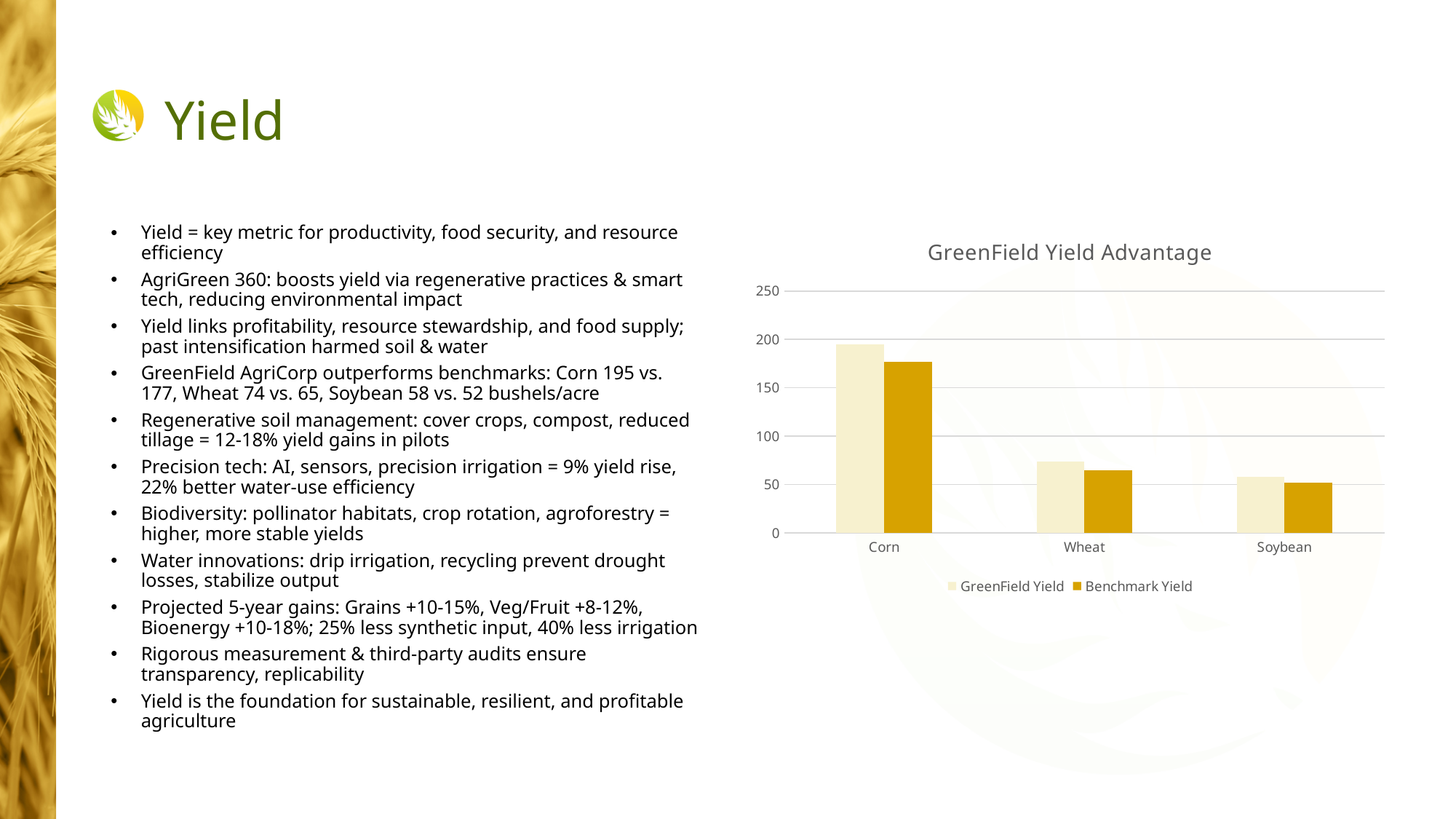
Which crop has the lowest Benchmark Yield in the chart? Soybean How many series does the chart legend list? 2 What is the GreenField Yield for Corn, as stated on the slide? 195 What is the difference between the GreenField Yield and the Benchmark Yield for Corn, using the values stated on the slide? 18 How many crop categories are shown on the x axis of the chart? 3 What type of chart is shown on the slide? bar chart Is the GreenField Yield for Soybean greater or less than 50? greater Which crop has the highest GreenField Yield in the chart? Corn Is the GreenField Yield for Corn greater or less than 150? greater What is the title of the chart? GreenField Yield Advantage For Wheat, which is larger: the GreenField Yield or the Benchmark Yield? GreenField Yield Is the Benchmark Yield for Wheat greater or less than 100? less